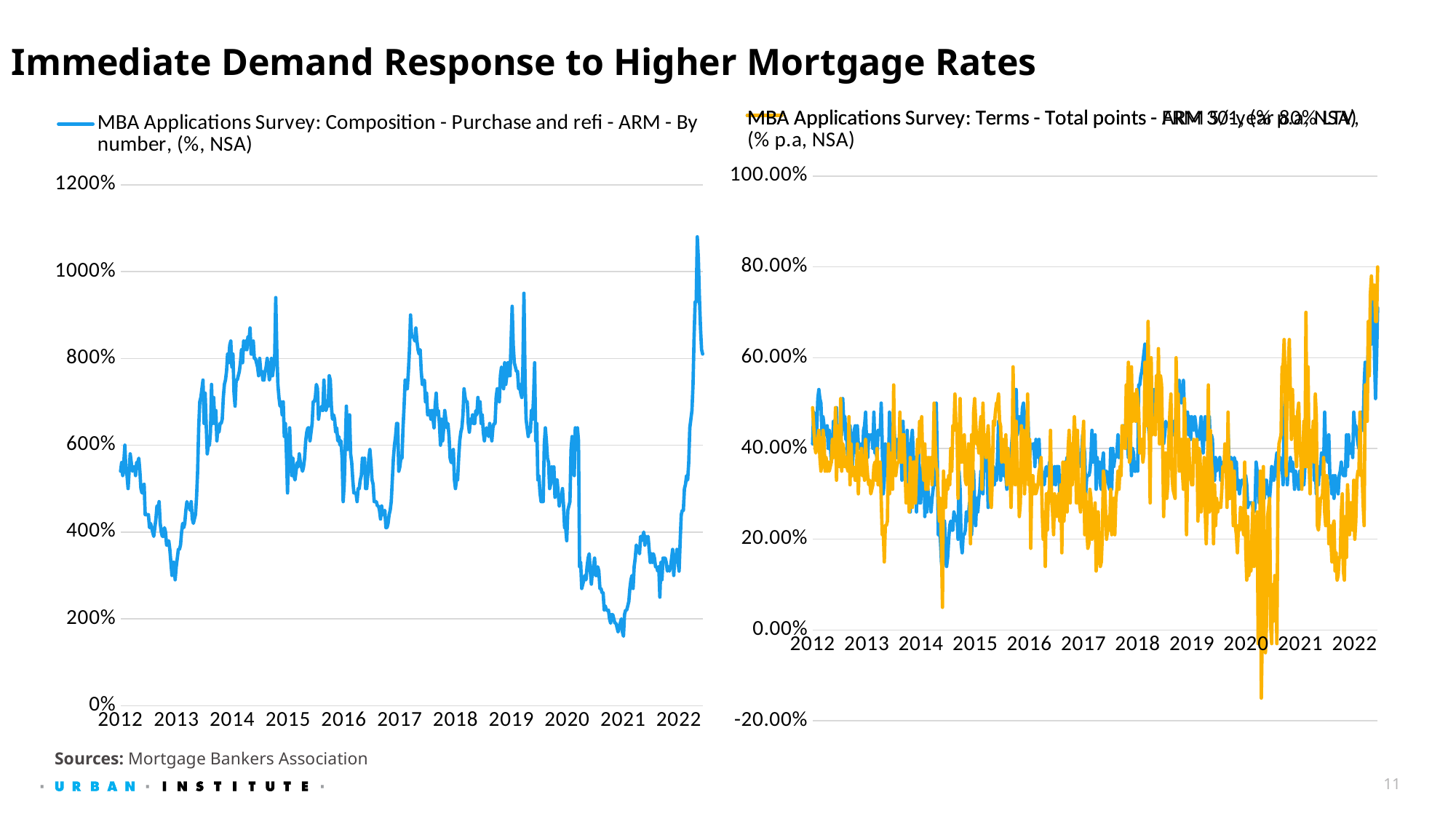
On the right chart, is the highest value of the orange series, reached in 2022, greater or less than 60.00%? greater What is the highest value shown on the vertical axis of the right chart? 100.00% What kind of chart is the left chart on the slide? Line chart On the left chart, is the lowest value reached in 2021 greater or less than 200%? less How many year labels appear on the horizontal axis of the left chart? 11 On the left chart, does the series rise or fall between 2019 and 2021? Fall On the left chart, is the peak value reached in 2022 greater or less than 1000%? greater How many series does the legend of the left chart list? 1 On the left chart, does the series rise or fall from 2021 to 2022? Rise What is the lowest value shown on the vertical axis of the right chart? -20.00% How many series does the legend of the right chart list? 2